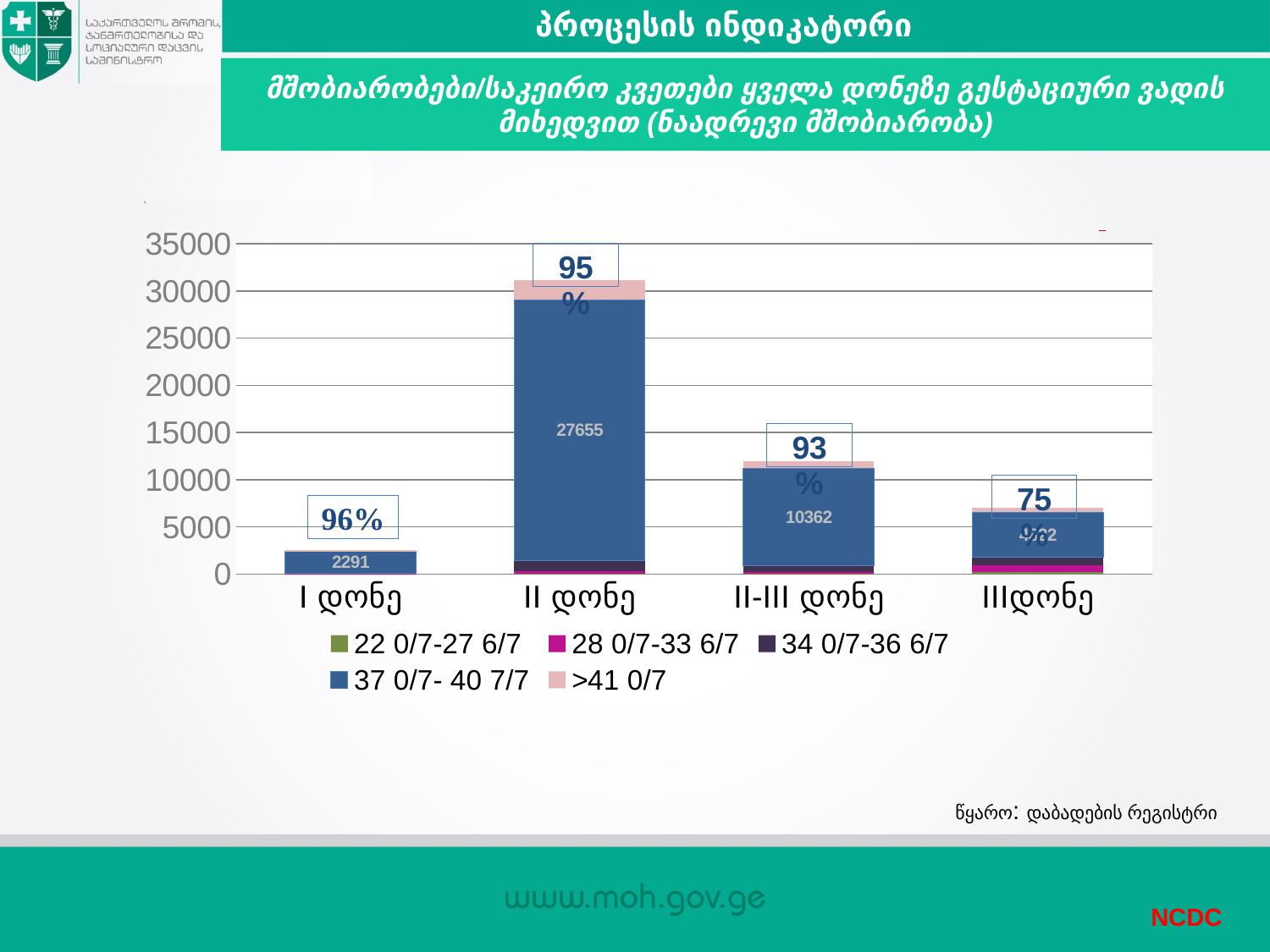
How many series does the chart legend list? 5 What is the value of the 37 0/7- 40 7/7 series for II-III დონე? 10362 Which is larger for the 37 0/7- 40 7/7 series: II-III დონე or I დონე? II-III დონე How many categories are shown on the x axis of the chart? 4 What percentage label is shown above the bar for I დონე? 96% Which category has the highest value for the 37 0/7- 40 7/7 series? II დონე What is the difference between the 37 0/7- 40 7/7 values for II დონე and II-III დონე? 17293 What is the value of the 37 0/7- 40 7/7 series for I დონე? 2291 What is the value of the 37 0/7- 40 7/7 series for II დონე? 27655 Which category has the lowest value for the 37 0/7- 40 7/7 series? I დონე Is the total height of the stacked bar for II დონე greater or less than 30000? greater What kind of chart is shown on the slide? bar chart